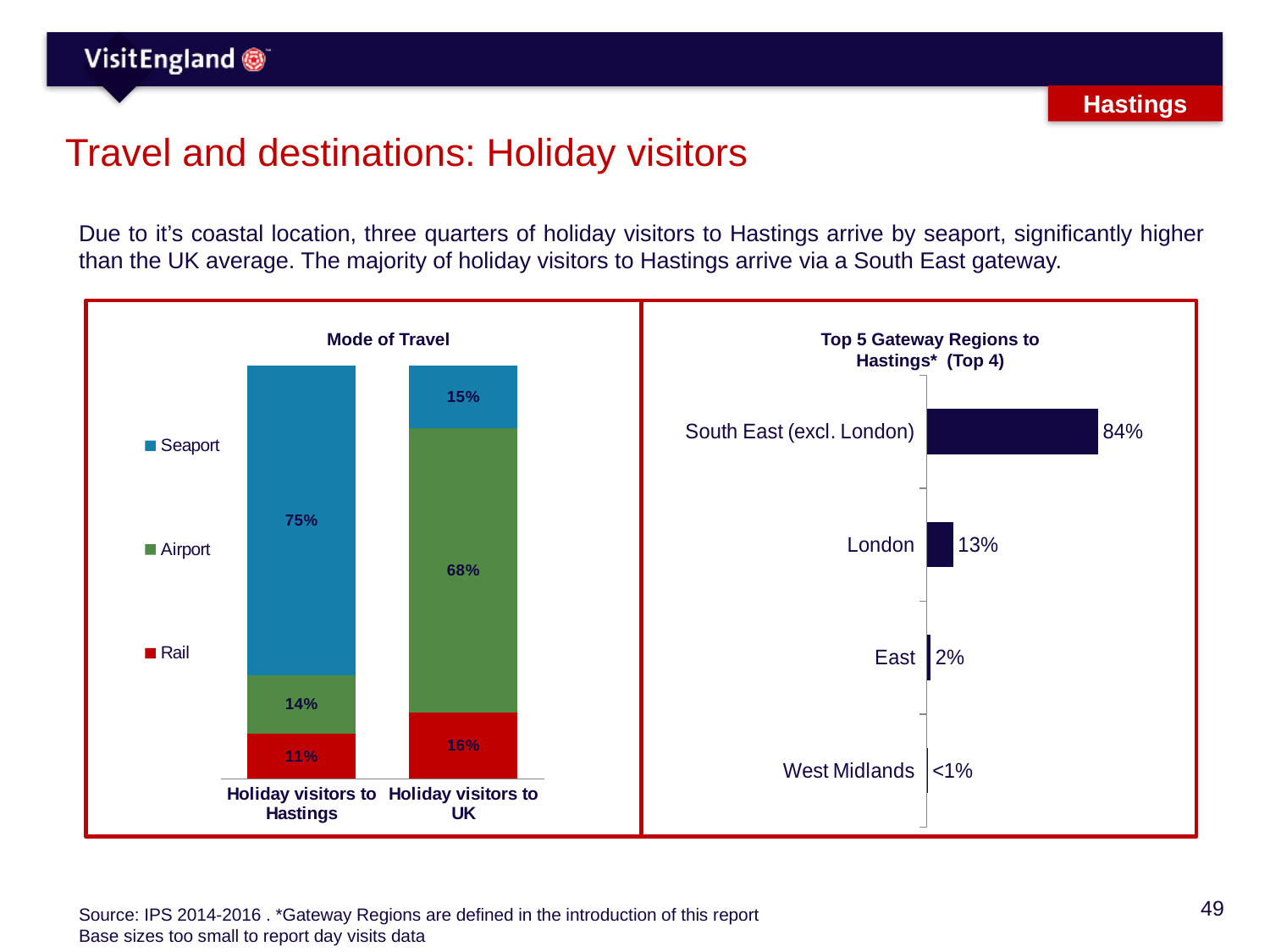
In the Mode of Travel chart, what percentage of holiday visitors to Hastings arrive by rail? 11% In the Mode of Travel chart, how many series does the legend list? 3 In the Mode of Travel chart, what is the difference between the seaport share for holiday visitors to Hastings and for holiday visitors to the UK? 60 percentage points In the Mode of Travel chart, what percentage of holiday visitors to the UK arrive by airport? 68% In the Mode of Travel chart, what is the total of the stacked bar for holiday visitors to Hastings? 100% In the Top 5 Gateway Regions to Hastings chart, what is the value for London? 13% In the Top 5 Gateway Regions to Hastings chart, how many regions are shown? 4 In the Top 5 Gateway Regions to Hastings chart, which region has the highest value? South East (excl. London) In the Mode of Travel chart, which is larger: the airport share for holiday visitors to Hastings or for holiday visitors to the UK? Holiday visitors to UK In the Mode of Travel chart, what percentage of holiday visitors to Hastings arrive by seaport? 75% In the Top 5 Gateway Regions to Hastings chart, which region has the lowest value? West Midlands What kind of chart is the Top 5 Gateway Regions to Hastings chart? Bar chart